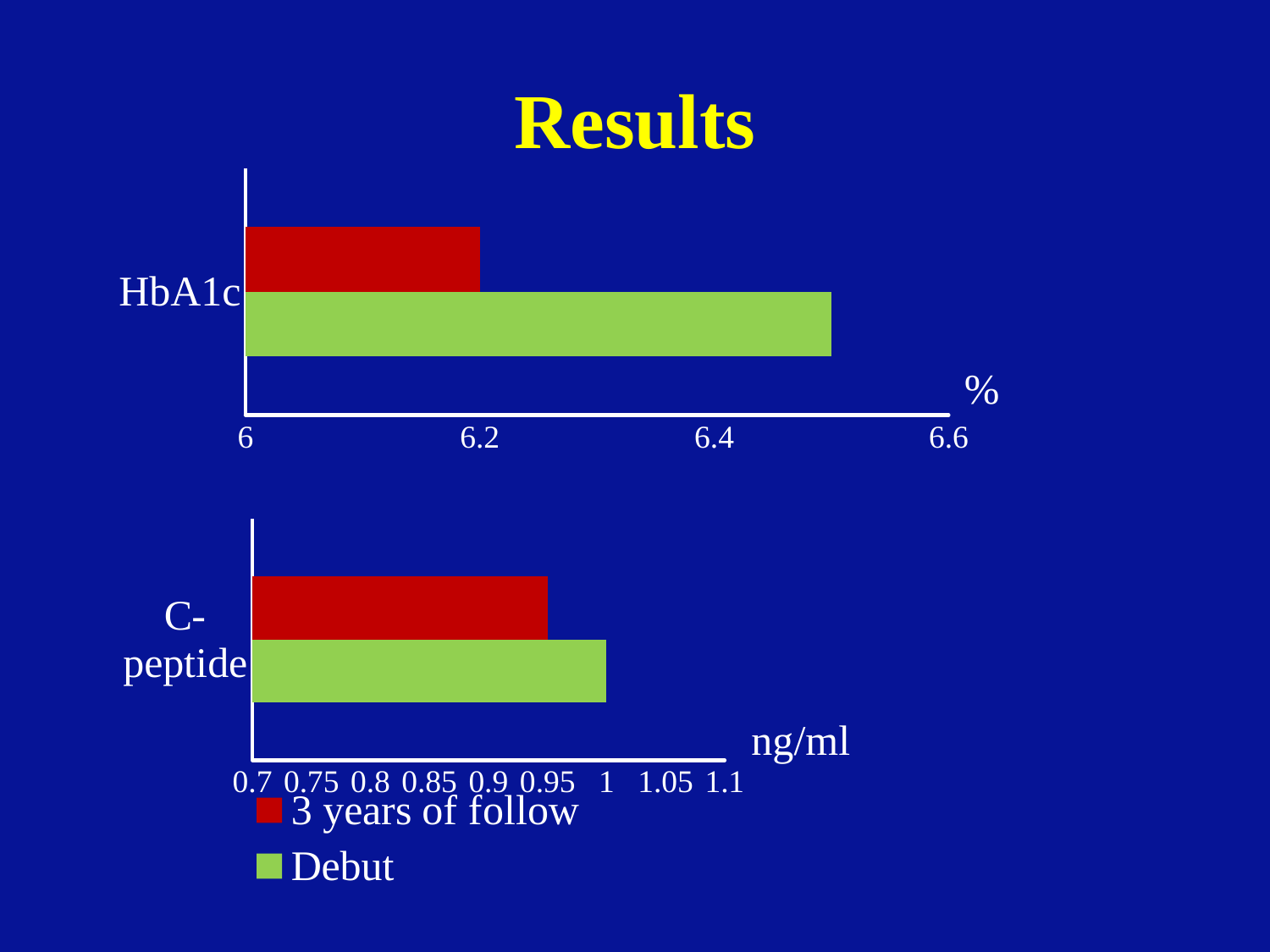
What unit is shown on the x axis of the C-peptide chart? ng/ml What unit is shown on the x axis of the HbA1c chart? % In the C-peptide chart, what is the value for Debut? 1 In the HbA1c chart, what is the value for 3 years of follow? 6.2 In the C-peptide chart, what is the difference between the Debut value and the 3 years of follow value? 0.05 In the HbA1c chart, is the value for Debut greater or less than 6.4? greater In the HbA1c chart, which series has the larger value, Debut or 3 years of follow? Debut In the C-peptide chart, which series has the larger value, Debut or 3 years of follow? Debut In the C-peptide chart, what is the value for 3 years of follow? 0.95 In the C-peptide chart, is the value for 3 years of follow greater or less than 0.9? greater What kind of chart is the HbA1c chart at the top of the slide? bar chart How many series does the legend list for the charts on the slide? 2